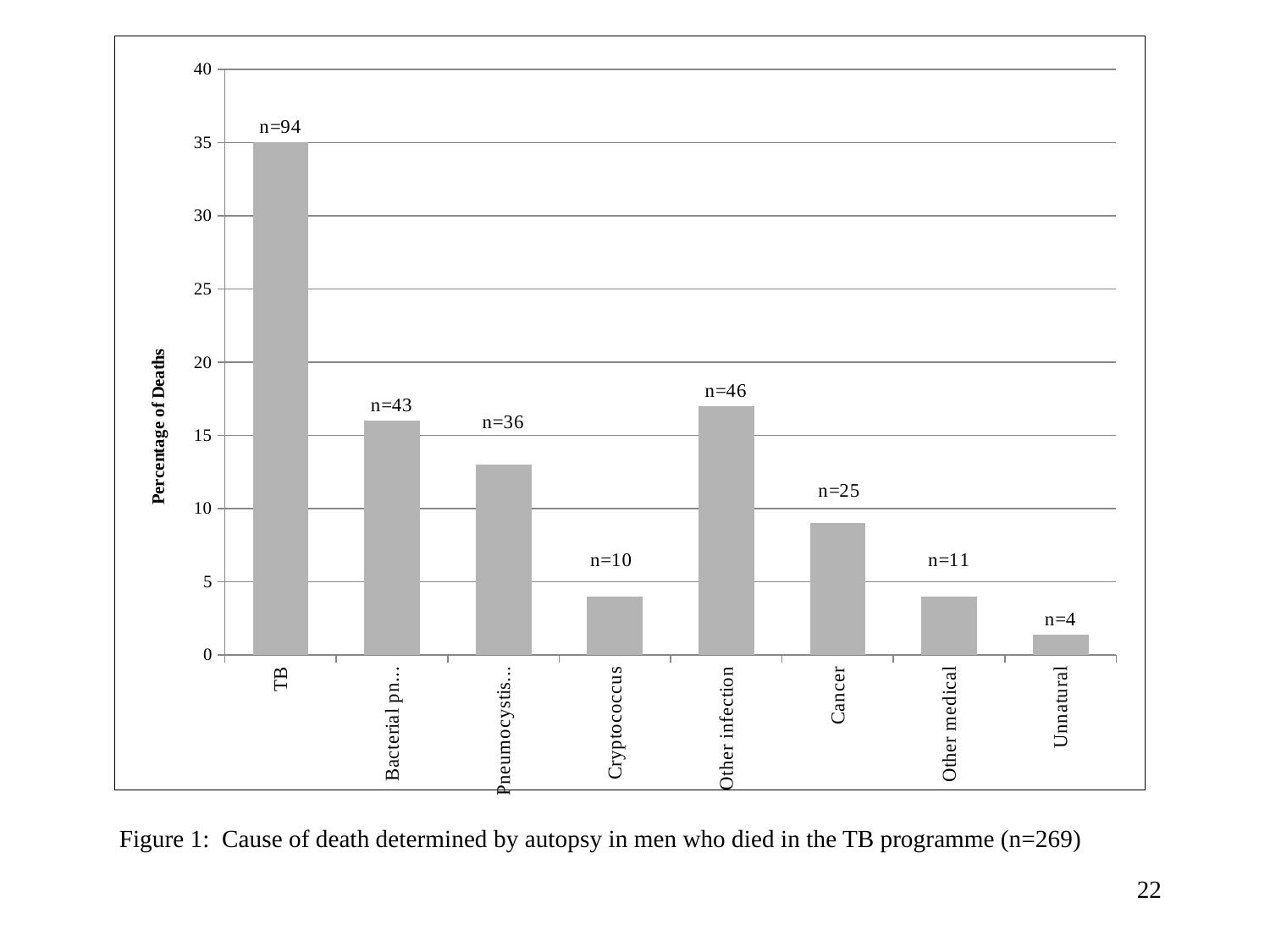
What is the n value printed above the Unnatural bar? n=4 Which cause of death has the lowest percentage of deaths? Unnatural Is the percentage of deaths for Other infection greater or less than 15? greater Is the percentage of deaths for Cancer greater or less than 10? less How many categories (causes of death) are shown on the x axis? 8 Which cause of death has the highest percentage of deaths? TB What is the n value printed above the Other infection bar? n=46 What is the title of the y axis? Percentage of Deaths Which has a higher percentage of deaths, Cancer or Cryptococcus? Cancer What is the n value printed above the TB bar? n=94 What is the n value printed above the Cancer bar? n=25 What kind of chart is shown on the slide? bar chart